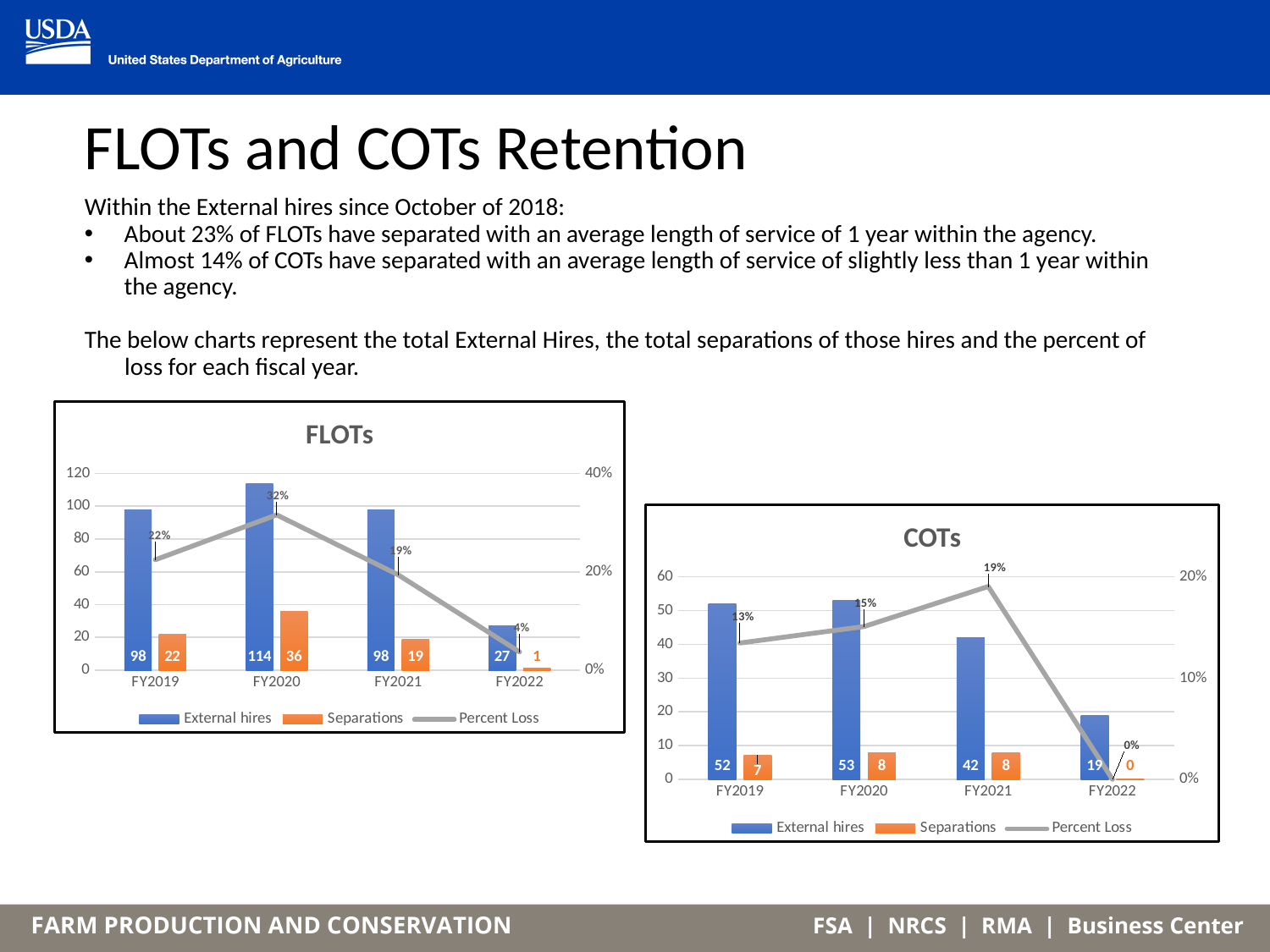
In the FLOTs chart, what is the Percent Loss for FY2021? 19% In the FLOTs chart, which series is plotted as a line rather than bars? Percent Loss In the FLOTs chart, what is the difference between External hires and Separations in FY2019? 76 In the COTs chart, how many fiscal years are shown on the x axis? 4 In the COTs chart, what is the Percent Loss for FY2021? 19% In the COTs chart, is the External hires value for FY2019 larger or smaller than the External hires value for FY2021? larger In the COTs chart, does the Percent Loss line rise or fall from FY2021 to FY2022? fall In the FLOTs chart, which fiscal year has the highest number of Separations? FY2020 In the FLOTs chart, what is the value of External hires for FY2020? 114 In the COTs chart, what is the value of Separations for FY2020? 8 In the FLOTs chart, how many series does the legend list? 3 In the COTs chart, which fiscal year has the lowest number of External hires? FY2022